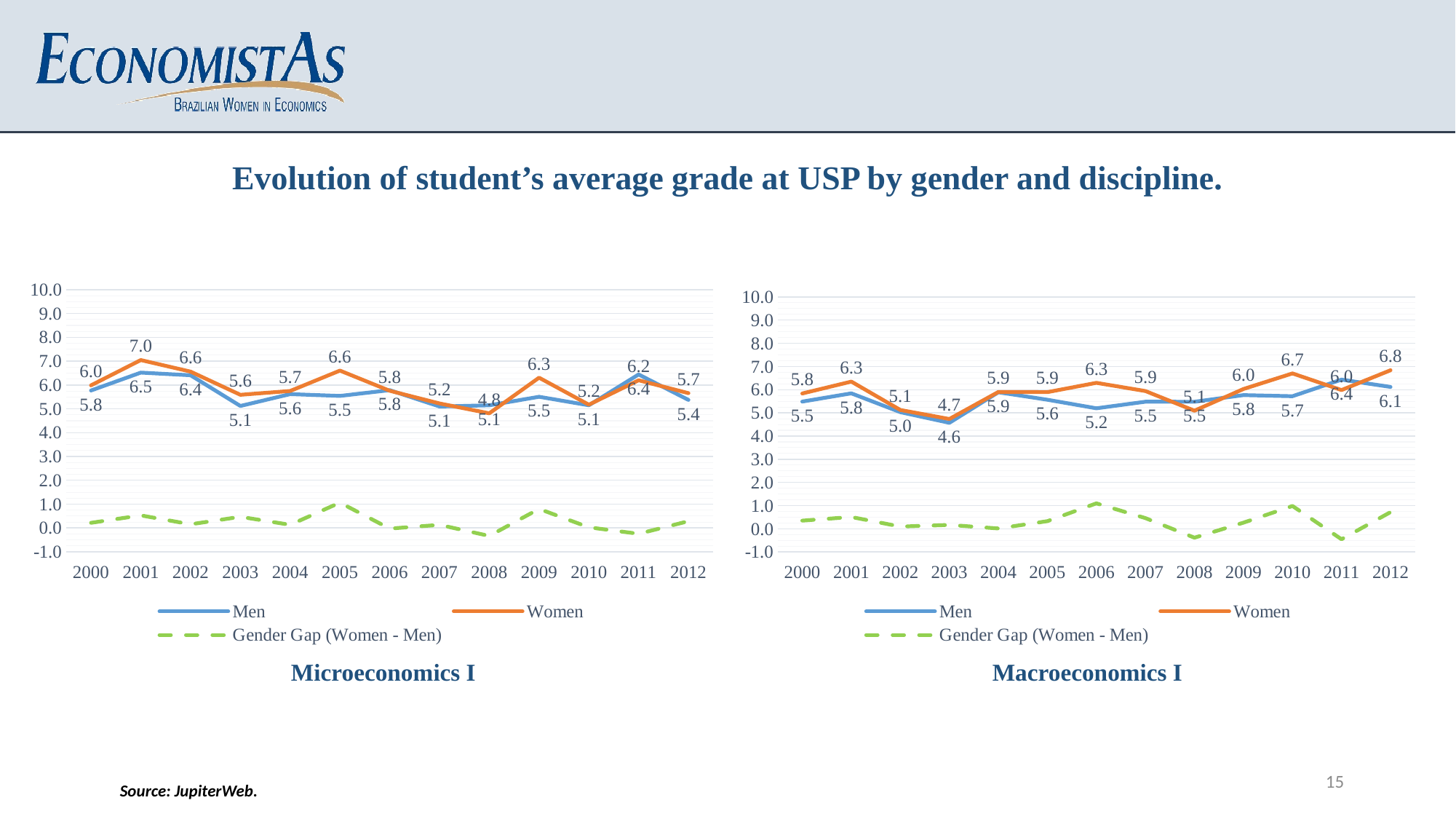
In the Macroeconomics I chart, what was the average grade for Men in 2003? 4.6 What type of chart is the Microeconomics I chart? Line chart In the Macroeconomics I chart, in which year was the Men series lowest? 2003 How many years are shown on the x axis of the Microeconomics I chart? 13 In the Microeconomics I chart, in which year was the Women series highest? 2001 In the Microeconomics I chart, what is the difference between the Women and Men grades in 2005? 1.1 How many series does the legend of the Macroeconomics I chart list? 3 In the Macroeconomics I chart, which series had the higher grade in 2006, Men or Women? Women In the Microeconomics I chart, what was the average grade for Women in 2001? 7.0 In the Microeconomics I chart, what was the average grade for Men in 2003? 5.1 In the Macroeconomics I chart, what was the average grade for Women in 2012? 6.8